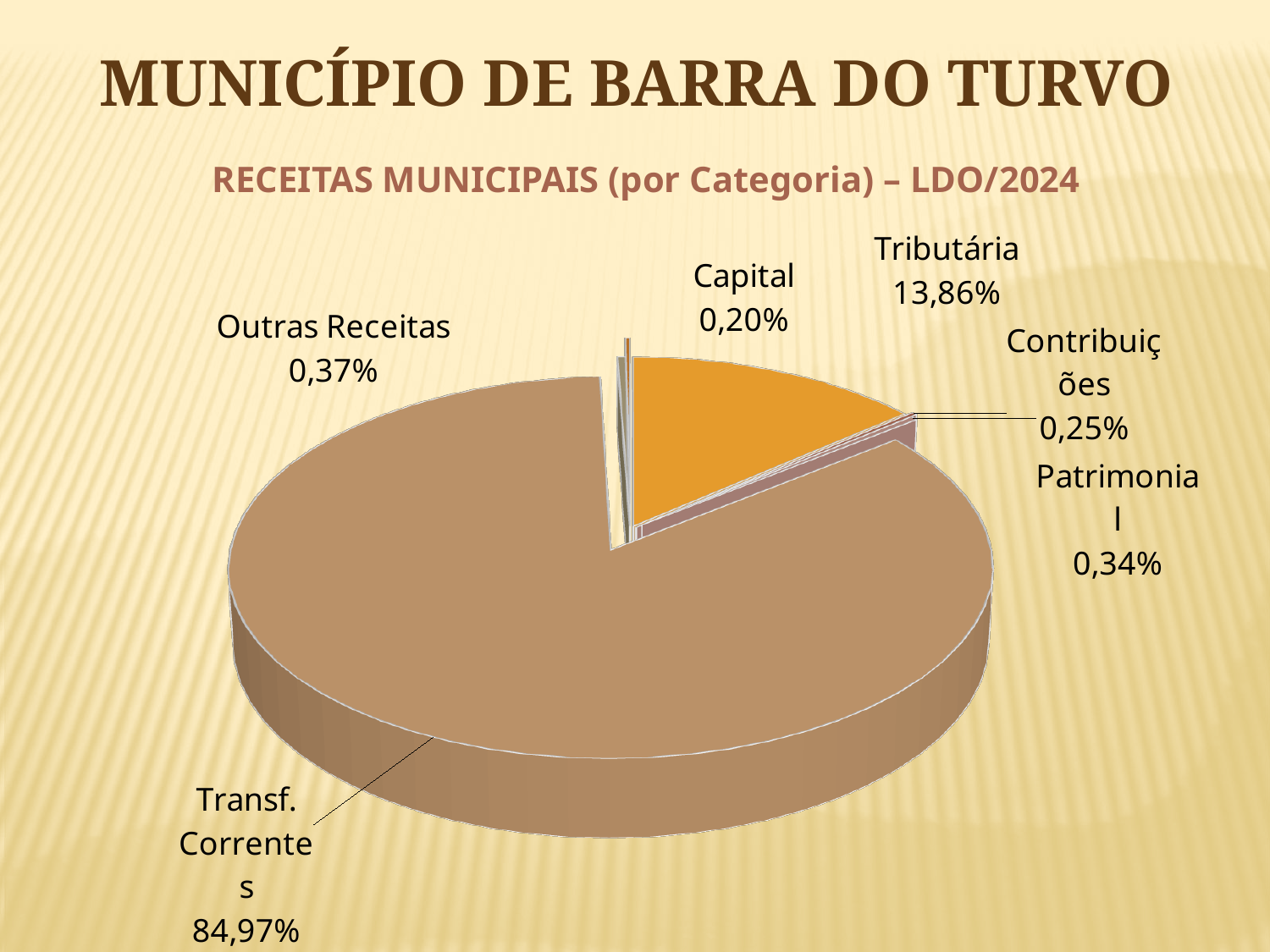
What is the share for Capital? 0,20% What is the share for Transf. Correntes? 84,97% What is the share for Tributária? 13,86% What is the share for Outras Receitas? 0,37% How many categories are shown in the pie chart? 6 What is the difference in percentage points between Transf. Correntes and Tributária? 71,11 Which category has the smallest share of the pie? Capital What is the share for Patrimonial? 0,34% What is the title of the chart? RECEITAS MUNICIPAIS (por Categoria) – LDO/2024 What kind of chart is shown on the slide? Pie chart Which category has the largest share of the pie? Transf. Correntes What is the share for Contribuições? 0,25%